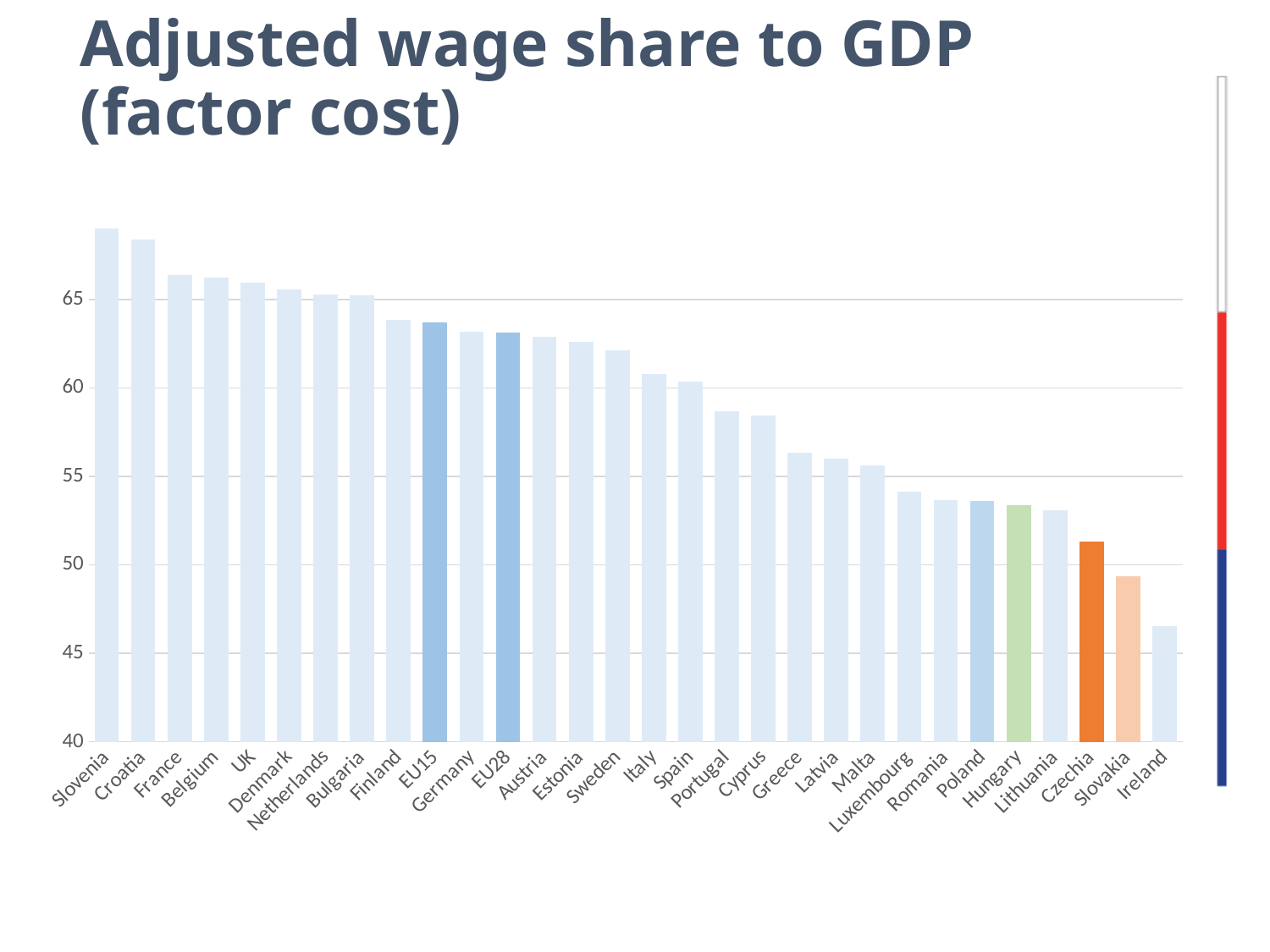
What kind of chart is shown on the slide? bar chart What is the title of the chart on the slide? Adjusted wage share to GDP (factor cost) Is the value for Ireland greater or less than 50? less Is the value for Portugal greater or less than 60? less Do the values rise or fall moving from left to right along the x axis? fall How many countries or groups are shown on the x axis of the chart? 30 Which country has the lowest adjusted wage share to GDP in the chart? Ireland Is the value for Finland greater or less than 65? less Which country has the highest adjusted wage share to GDP in the chart? Slovenia Which has the larger adjusted wage share, Czechia or Slovakia? Czechia